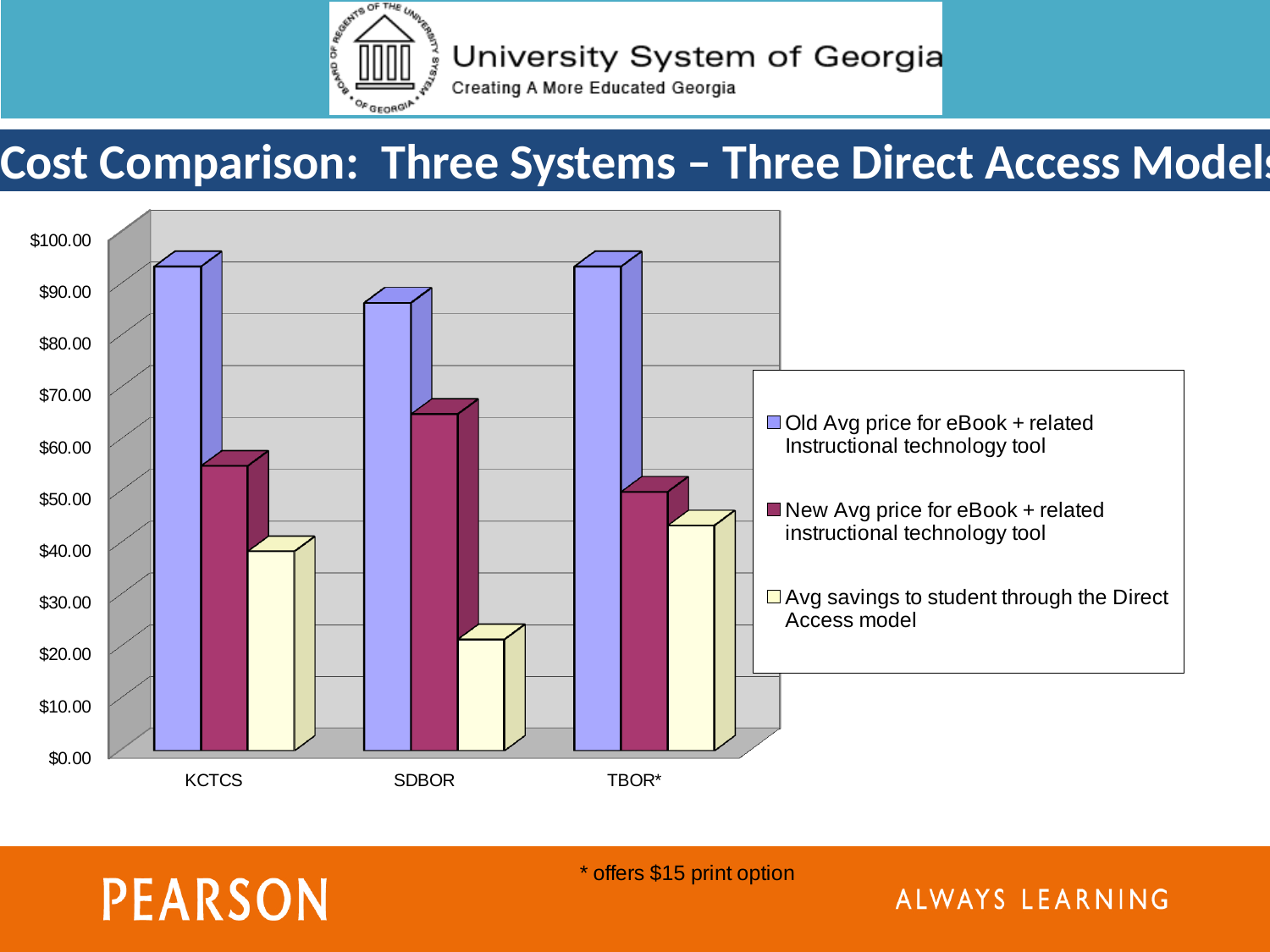
How many series does the chart's legend list? 3 How many categories are shown on the x axis of the chart? 3 Is the 'Old Avg price for eBook + related Instructional technology tool' value for KCTCS greater or less than $90.00? greater Which category has the lowest value for 'Avg savings to student through the Direct Access model'? SDBOR What kind of chart is shown on the slide? bar chart Which category has the highest value for 'New Avg price for eBook + related instructional technology tool'? SDBOR What is the title of the slide containing the chart? Cost Comparison: Three Systems – Three Direct Access Models Is the 'Avg savings to student through the Direct Access model' value for SDBOR greater or less than $30.00? less Is the 'Avg savings to student through the Direct Access model' value for KCTCS greater or less than $50.00? less Which is larger: the 'New Avg price for eBook + related instructional technology tool' for SDBOR or for KCTCS? SDBOR Which category has the lowest value for 'Old Avg price for eBook + related Instructional technology tool'? SDBOR